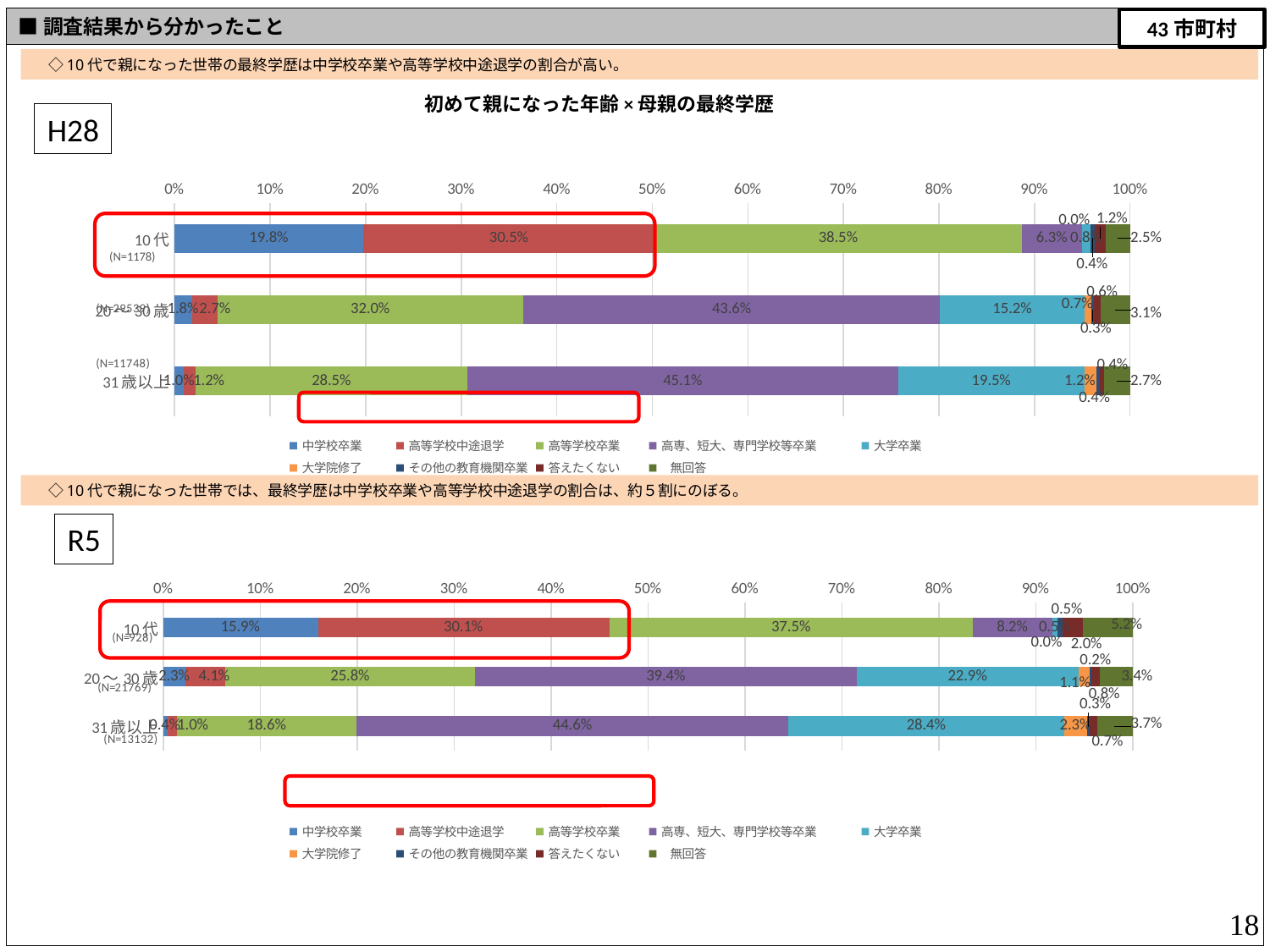
In the H28 chart, which age group has the highest 中学校卒業 share? 10代 What kind of chart is the R5 chart? Stacked horizontal bar chart In the H28 chart, how many percentage points higher is the 高等学校卒業 share for 10代 than for 20～30歳? 6.5 percentage points In the H28 chart, what is the 高専、短大、専門学校等卒業 share for the 31歳以上 group? 45.1% In the R5 chart, what is the 中学校卒業 share for the 10代 group? 15.9% What is the title of the H28 chart? 初めて親になった年齢×母親の最終学歴 In the H28 chart, what percentage of the 10代 group has 高等学校卒業 as the mother's final education? 38.5% In the R5 chart, what is the 大学卒業 share for the 31歳以上 group? 28.4% How many age-group categories are plotted in the R5 chart? 3 In the R5 chart, which group has the larger 大学卒業 share, 20～30歳 or 31歳以上? 31歳以上 How many series does the legend of the H28 chart list? 9 In the R5 chart, which age group has the lowest 高等学校卒業 share? 31歳以上